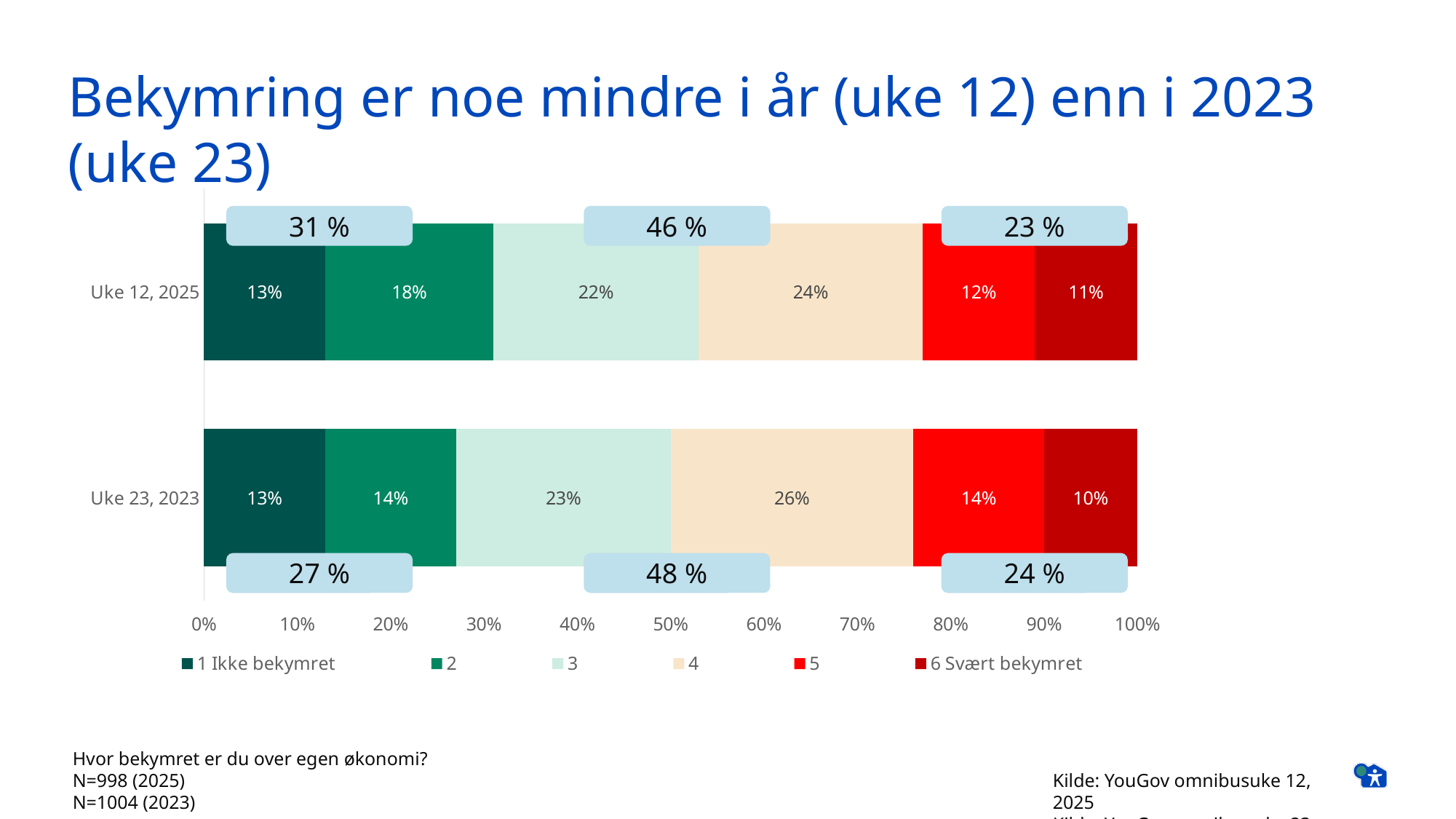
What is the value for series "5" in the "Uke 23, 2023" bar? 14% What is the value for series "2" in the "Uke 12, 2025" bar? 18% What is the value for "6 Svært bekymret" in the "Uke 12, 2025" bar? 11% Which series has the largest value in the "Uke 23, 2023" bar? 4 What is the value for series "4" in the "Uke 23, 2023" bar? 26% How many categories (bars) are plotted on the chart? 2 What kind of chart is shown on the slide? Stacked bar chart Which series has the smallest value in the "Uke 12, 2025" bar? 6 Svært bekymret How many series does the legend list? 6 Which is larger: the value for series "3" in "Uke 12, 2025" or in "Uke 23, 2023"? Uke 23, 2023 What is the difference between the value for series "2" in "Uke 12, 2025" and in "Uke 23, 2023"? 4% What is the combined share shown in the highlighted box for series 5 and 6 in the "Uke 23, 2023" bar? 24 %